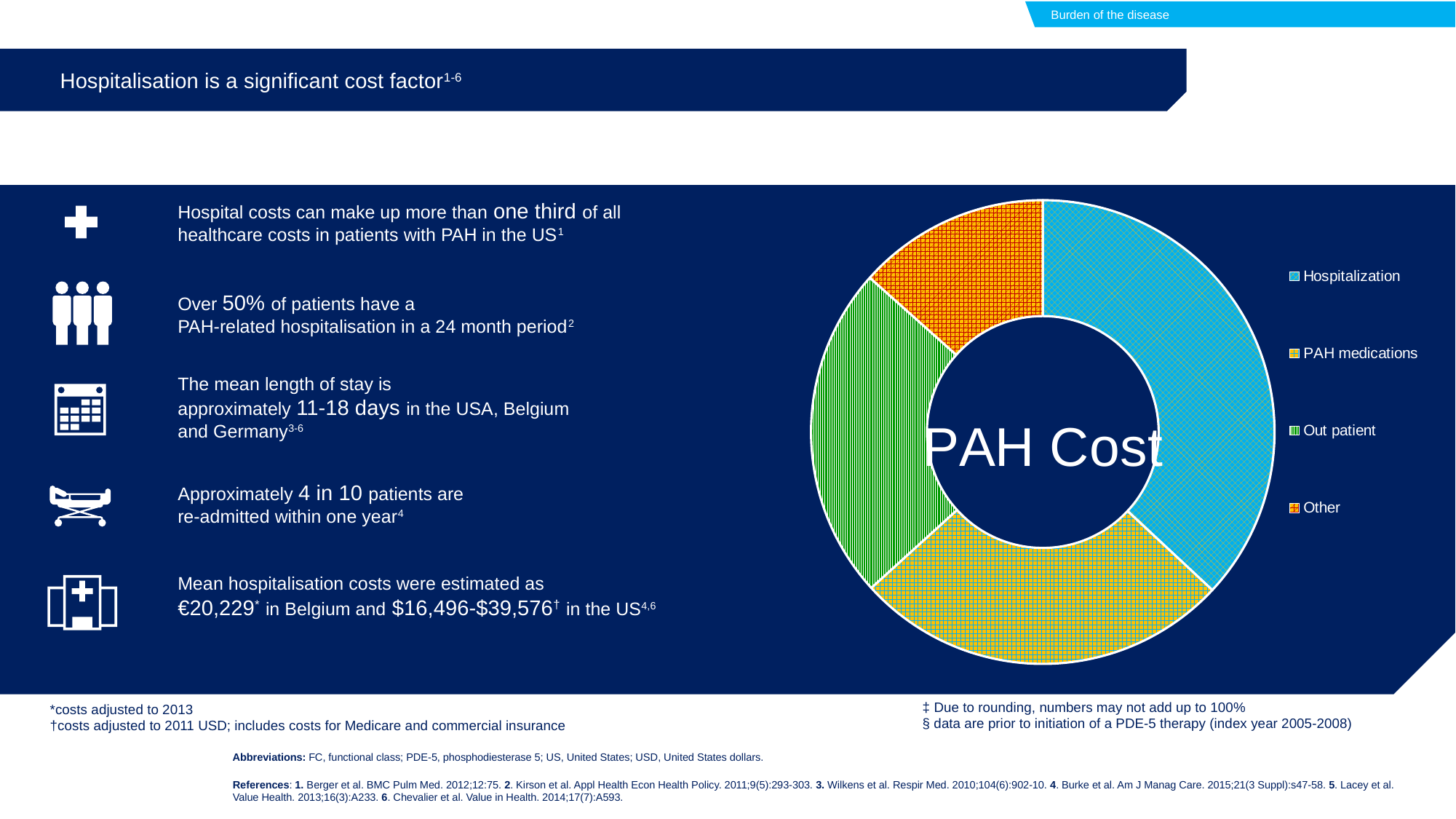
In the PAH Cost chart, which is larger: PAH medications or Other? PAH medications In the PAH Cost chart, which is larger: Hospitalization or PAH medications? Hospitalization Which category takes the smallest share of the PAH Cost chart? Other How many categories does the PAH Cost chart show? 4 In the PAH Cost chart, which is larger: Hospitalization or Out patient? Hospitalization What kind of chart is shown on the slide? doughnut chart How many entries does the legend of the PAH Cost chart list? 4 Which category takes the largest share of the PAH Cost chart? Hospitalization What text is written in the centre of the doughnut chart? PAH Cost What colour is the Out patient slice in the PAH Cost chart? green